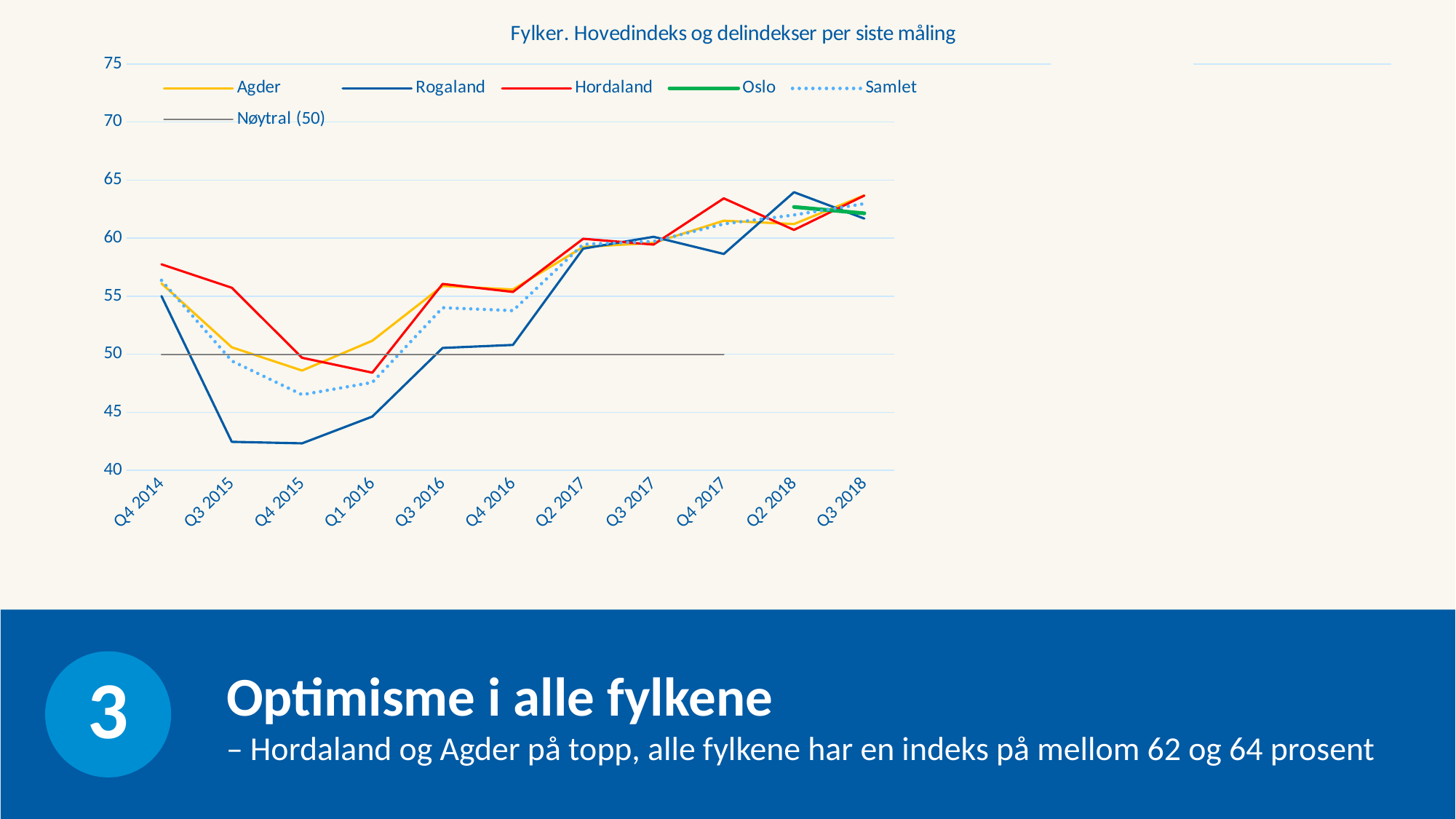
Does the Rogaland line rise or fall from Q4 2014 to Q3 2015? fall What is the title of the chart? Fylker. Hovedindeks og delindekser per siste måling In Q2 2018, which is higher: Rogaland or Hordaland? Rogaland Is the value for Rogaland in Q3 2015 greater or less than 45? less In Q4 2014, which is higher: Hordaland or Rogaland? Hordaland Is the value for Hordaland in Q4 2014 greater or less than 55? greater How many series does the legend list? 6 Is the value for Rogaland in Q2 2018 greater or less than 60? greater What kind of chart is shown on the slide? line chart At what value is the Nøytral line drawn? 50 How many quarters are shown along the x axis? 11